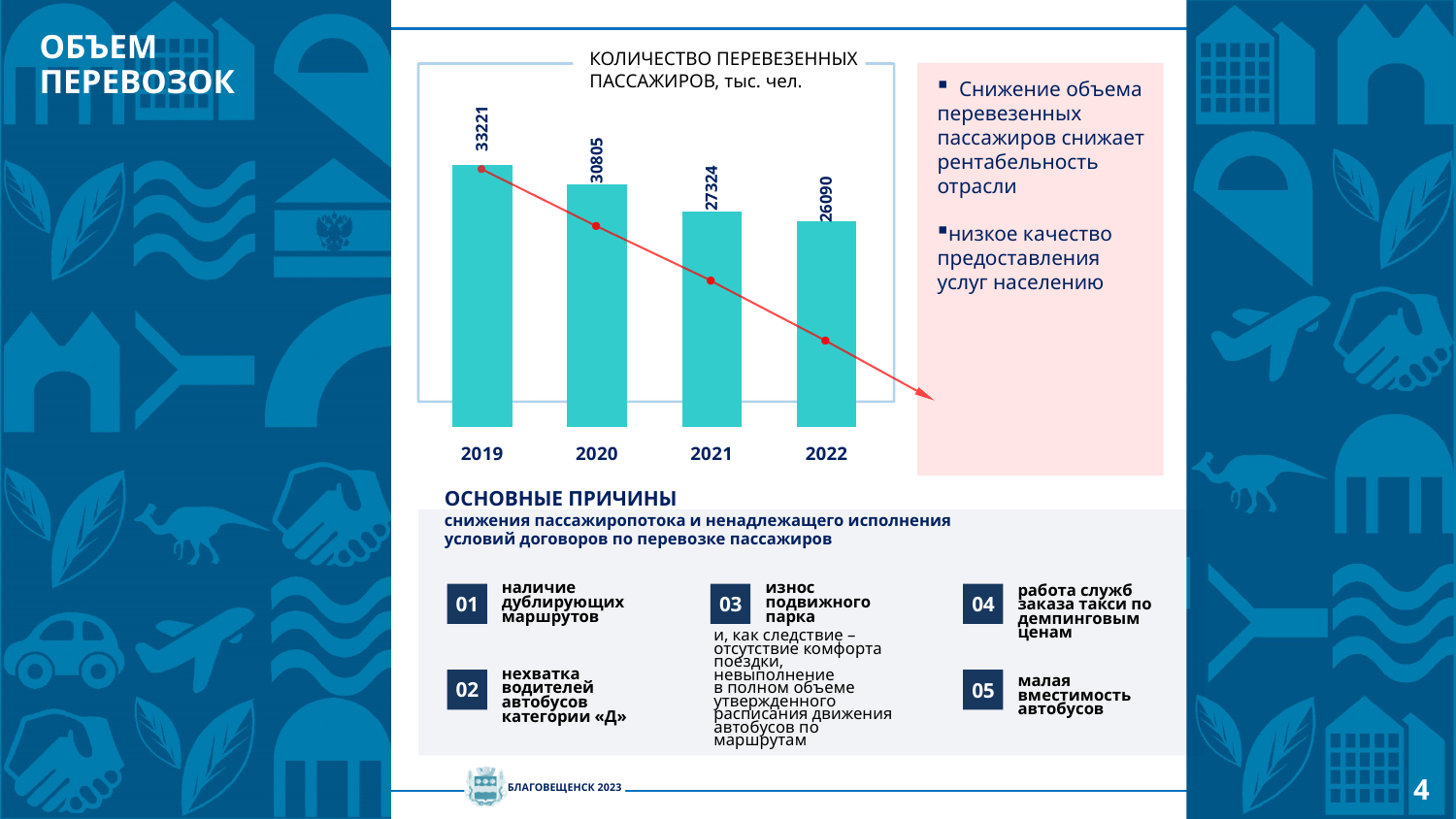
Which year has the highest number of passengers carried? 2019 What is the number of passengers carried in 2019? 33221 What is the number of passengers carried in 2022? 26090 How many years are shown on the chart? 4 Which year has more passengers carried, 2020 or 2021? 2020 Which year has the lowest number of passengers carried? 2022 Do the values rise or fall from 2019 to 2022? Fall What is the number of passengers carried in 2020? 30805 What is the difference between the number of passengers carried in 2020 and in 2021? 3481 What kind of chart is used to show the number of passengers carried? Bar chart What is the difference between the number of passengers carried in 2019 and in 2022? 7131 What is the number of passengers carried in 2021? 27324